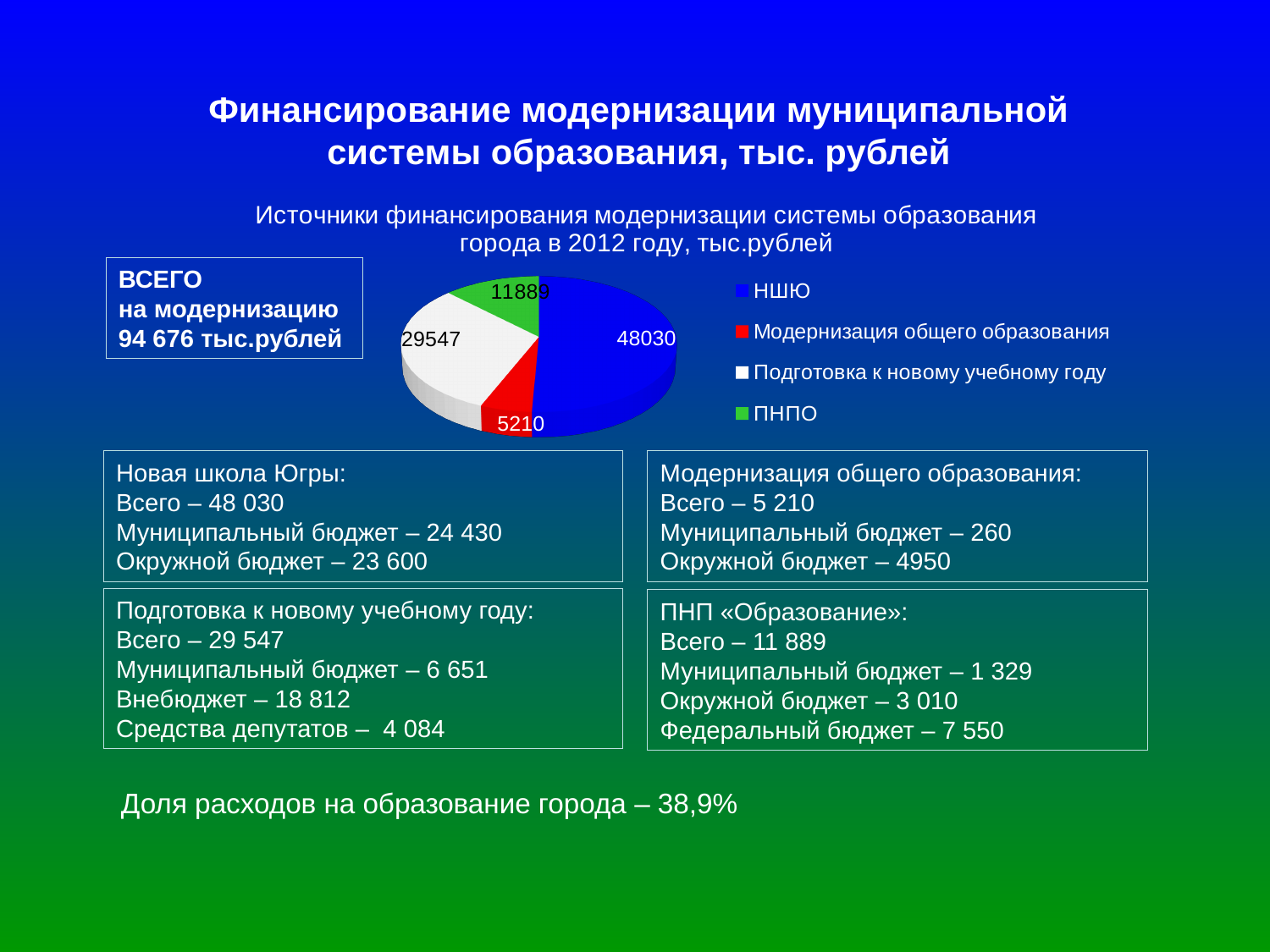
What type of chart is shown on the slide? pie chart What is the value for Модернизация общего образования in the pie chart? 5210 What is the title of the pie chart? Источники финансирования модернизации системы образования города в 2012 году, тыс.рублей What is the difference between the values for НШЮ and Модернизация общего образования? 42820 Which category has the largest slice in the pie chart? НШЮ What is the difference between the values for Подготовка к новому учебному году and ПНПО? 17658 Which is larger: the value for ПНПО or the value for Подготовка к новому учебному году? Подготовка к новому учебному году How many slices does the pie chart have? 4 What is the value for Подготовка к новому учебному году in the pie chart? 29547 What is the value for ПНПО in the pie chart? 11889 What is the value for НШЮ in the pie chart? 48030 Which category has the smallest slice in the pie chart? Модернизация общего образования